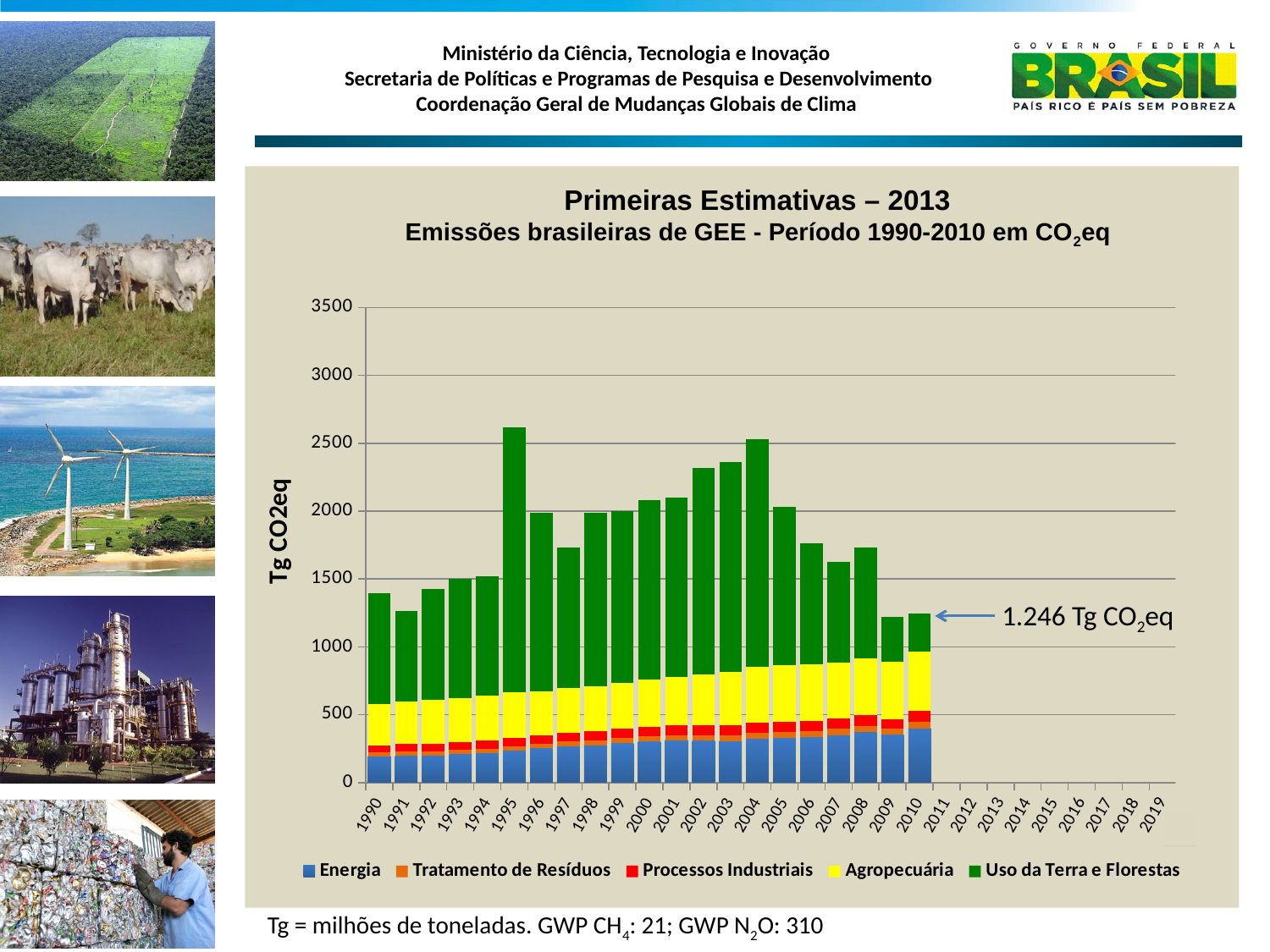
Which year has the larger total emissions, 2006 or 2007? 2006 What is the total emissions value annotated for 2010? 1.246 Tg CO2eq Which year has the highest total emissions? 1995 How many years have bars plotted in the chart? 21 Which year has the larger total emissions, 1996 or 1997? 1996 Is the total emissions value for 1990 greater or less than 1500? less Which series is shown in green in the chart? Uso da Terra e Florestas Does the Energia series rise or fall from 1990 to 2010? Rises Is the total emissions value for 1995 greater or less than 2500? greater How many series does the chart legend list? 5 Is the total emissions value for 2002 greater or less than 2000? greater What kind of chart is shown on the slide? Stacked bar chart